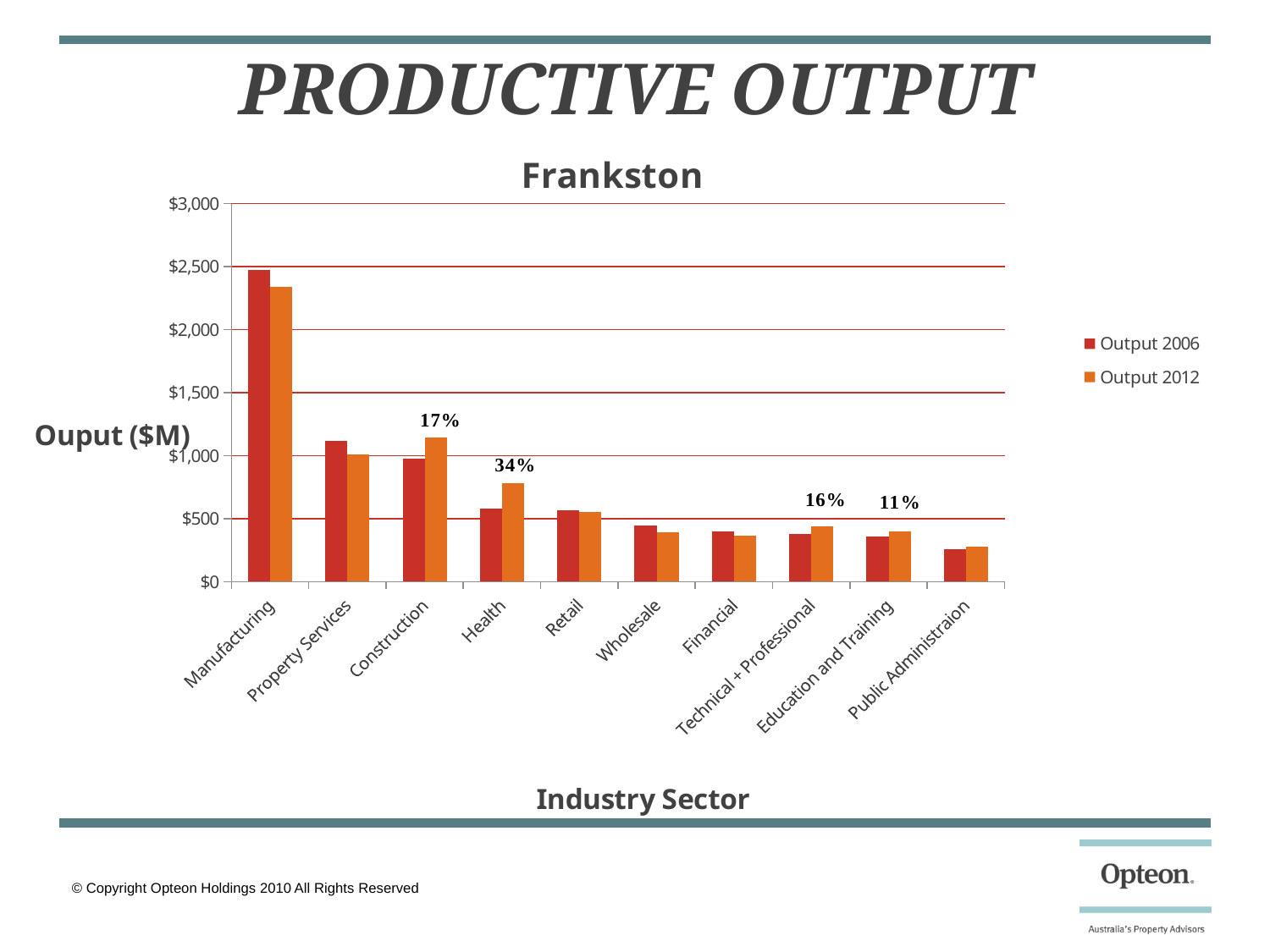
What is the title of the chart? Frankston For Health, which is larger: Output 2006 or Output 2012? Output 2012 Is the Output 2012 value for Health greater or less than $1,000? less How many series does the legend list? 2 Which industry sector has the highest Output 2006 value? Manufacturing For Manufacturing, which is larger: Output 2006 or Output 2012? Output 2006 How many industry sectors are shown on the x axis? 10 Is the Output 2006 value for Manufacturing greater or less than $2,000? greater Is the Output 2012 value for Construction greater or less than $1,000? greater Which industry sector has the lowest Output 2012 value? Public Administraion What kind of chart is shown on the slide? Bar chart